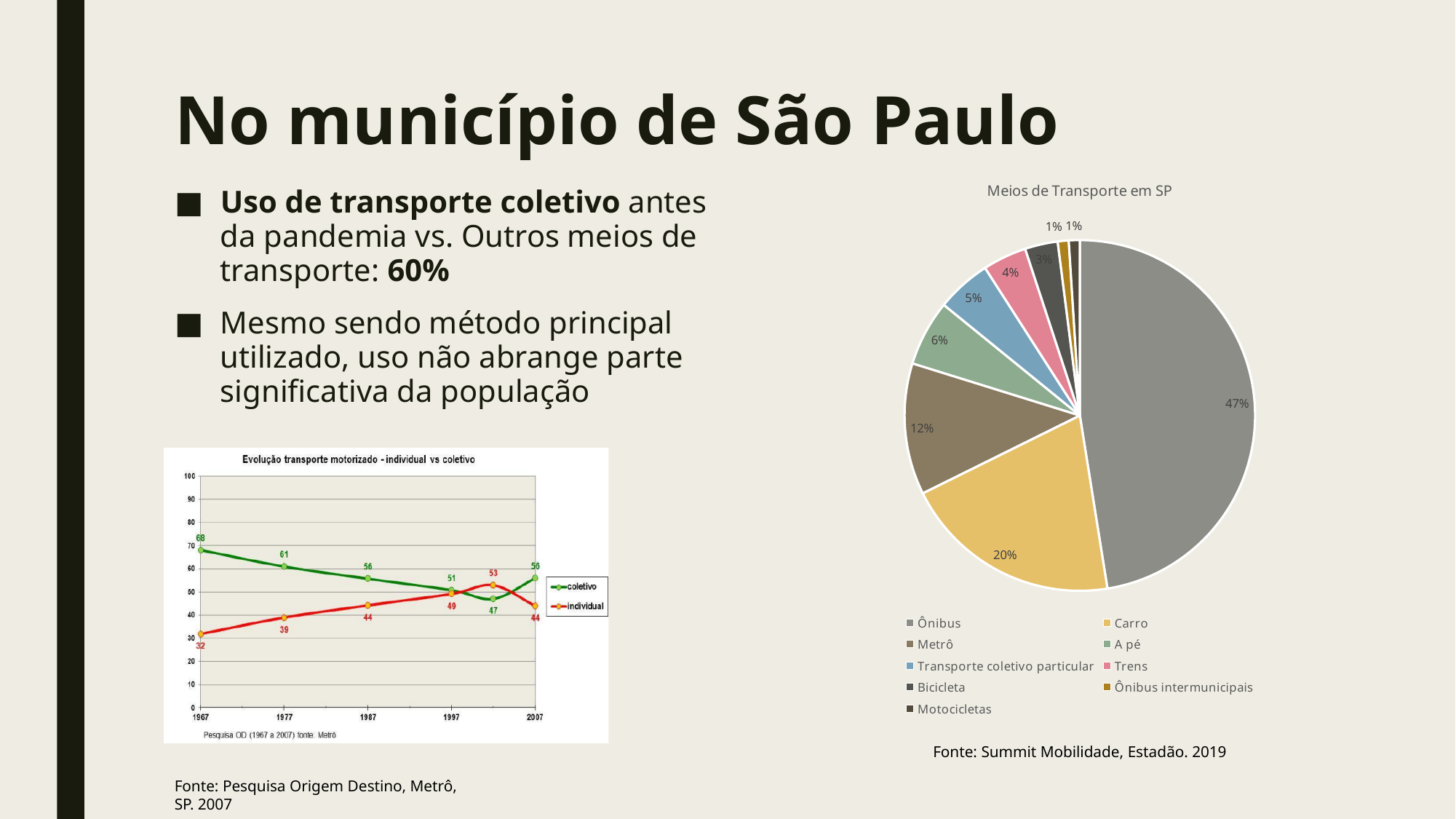
In the pie chart 'Meios de Transporte em SP', what share does Carro have? 20% In the line chart 'Evolução transporte motorizado - individual vs coletivo', how many series does the legend list? 2 In the line chart 'Evolução transporte motorizado - individual vs coletivo', what is the difference between coletivo and individual in 1967? 36 In the line chart 'Evolução transporte motorizado - individual vs coletivo', what is the value of individual in 1997? 49 In the line chart 'Evolução transporte motorizado - individual vs coletivo', does the individual series rise or fall from 1967 to 1997? Rise In the pie chart 'Meios de Transporte em SP', which is larger, the share of A pé or the share of Trens? A pé How many categories does the legend of the pie chart 'Meios de Transporte em SP' list? 9 In the pie chart 'Meios de Transporte em SP', what is the difference between the shares of Carro and Metrô? 8% In the line chart 'Evolução transporte motorizado - individual vs coletivo', what is the value of coletivo in 1967? 68 In the pie chart 'Meios de Transporte em SP', what share does Ônibus have? 47% What kind of chart is 'Meios de Transporte em SP'? Pie chart In the pie chart 'Meios de Transporte em SP', which category has the largest share? Ônibus